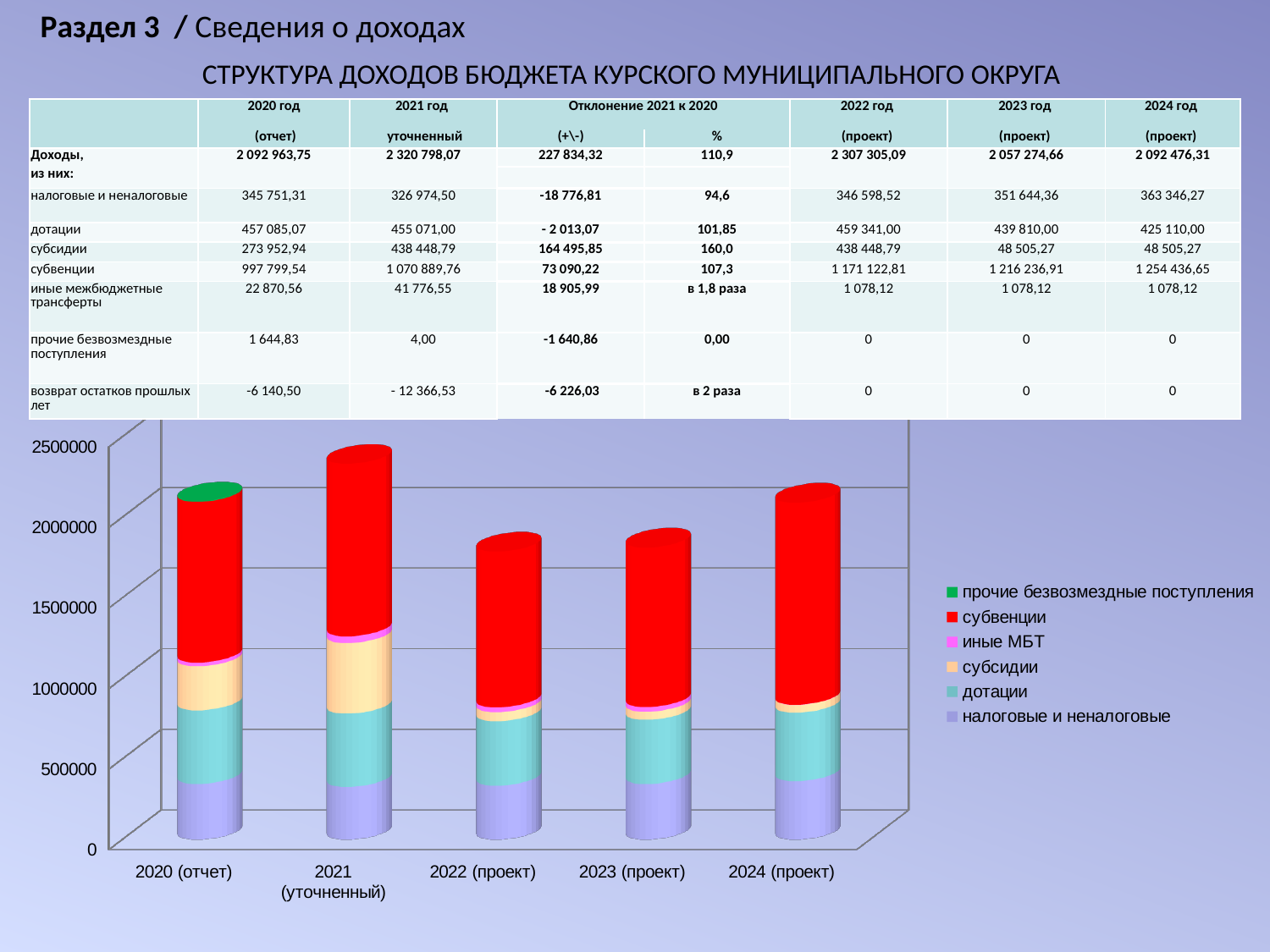
Which series occupies the largest segment of each stacked bar? субвенции Is the total bar for 2022 (проект) greater or less than 2000000? less Which year has the tallest stacked bar in the chart? 2021 (уточненный) Is the total bar for 2021 (уточненный) greater or less than 2000000? greater How many series does the chart legend list? 6 What colour represents субвенции in the chart legend? red What kind of chart is shown on the slide? stacked bar chart Which is larger, the total bar for 2021 (уточненный) or for 2024 (проект)? 2021 (уточненный) How many year categories are shown along the x axis of the chart? 5 Which is larger, the total bar for 2020 (отчет) or for 2021 (уточненный)? 2021 (уточненный) What is the highest value shown on the chart's y axis? 2500000 Does the total bar height rise or fall from 2021 (уточненный) to 2022 (проект)? fall